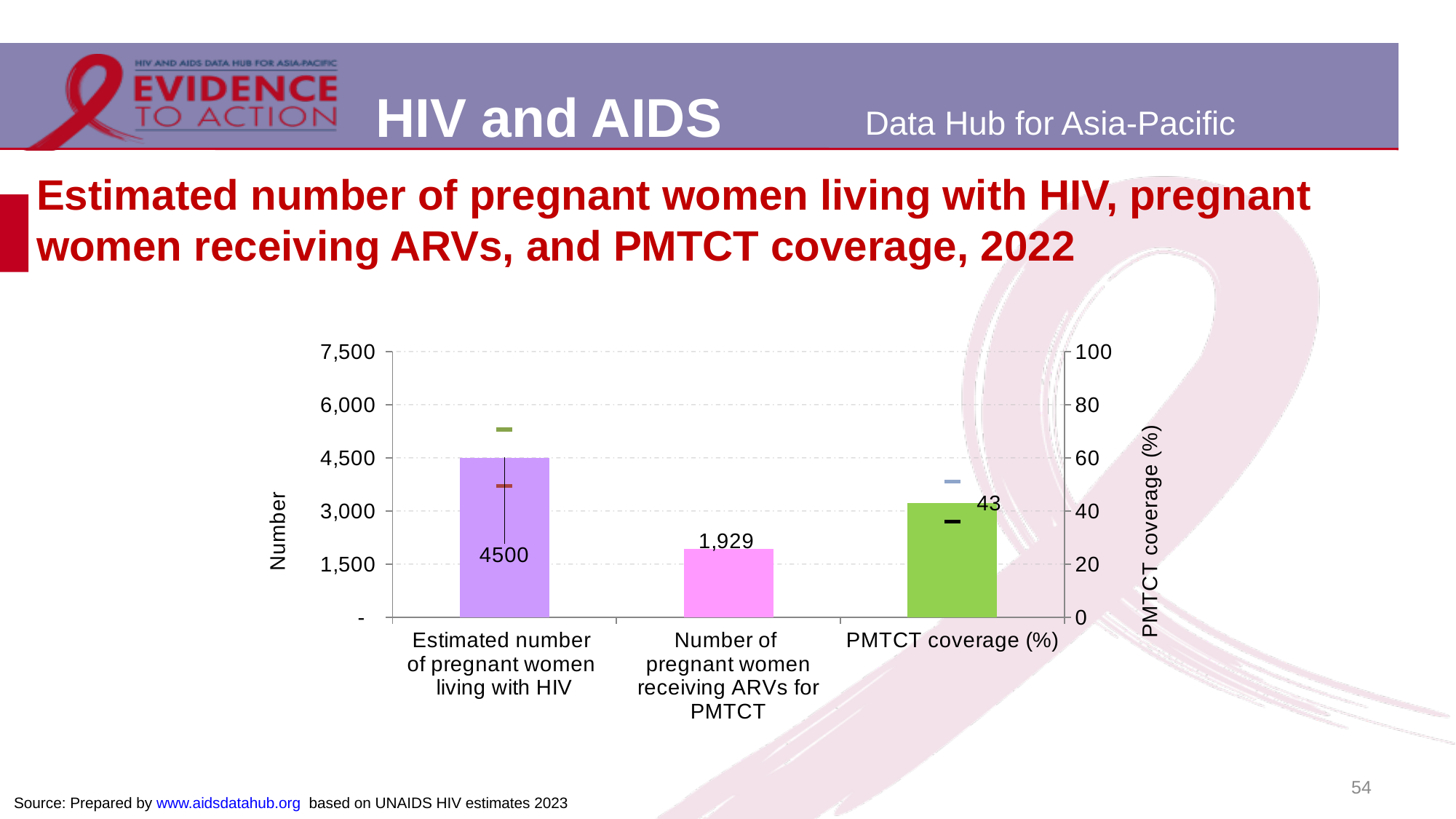
Which year does the chart's data refer to, according to the slide title? 2022 What is the title of the right vertical axis of the chart? PMTCT coverage (%) What is the number of pregnant women receiving ARVs for PMTCT shown on the chart? 1,929 What is the PMTCT coverage (%) shown on the chart? 43 What is the highest tick value shown on the right vertical axis? 100 What is the difference between the estimated number of pregnant women living with HIV and the number of pregnant women receiving ARVs for PMTCT? 2,571 What kind of chart is shown on the slide? Bar chart What is the estimated number of pregnant women living with HIV shown on the chart? 4500 What is the highest tick value shown on the left vertical axis? 7,500 How many bars are plotted on the chart? 3 What is the title of the left vertical axis of the chart? Number Which is larger: the estimated number of pregnant women living with HIV or the number of pregnant women receiving ARVs for PMTCT? Estimated number of pregnant women living with HIV